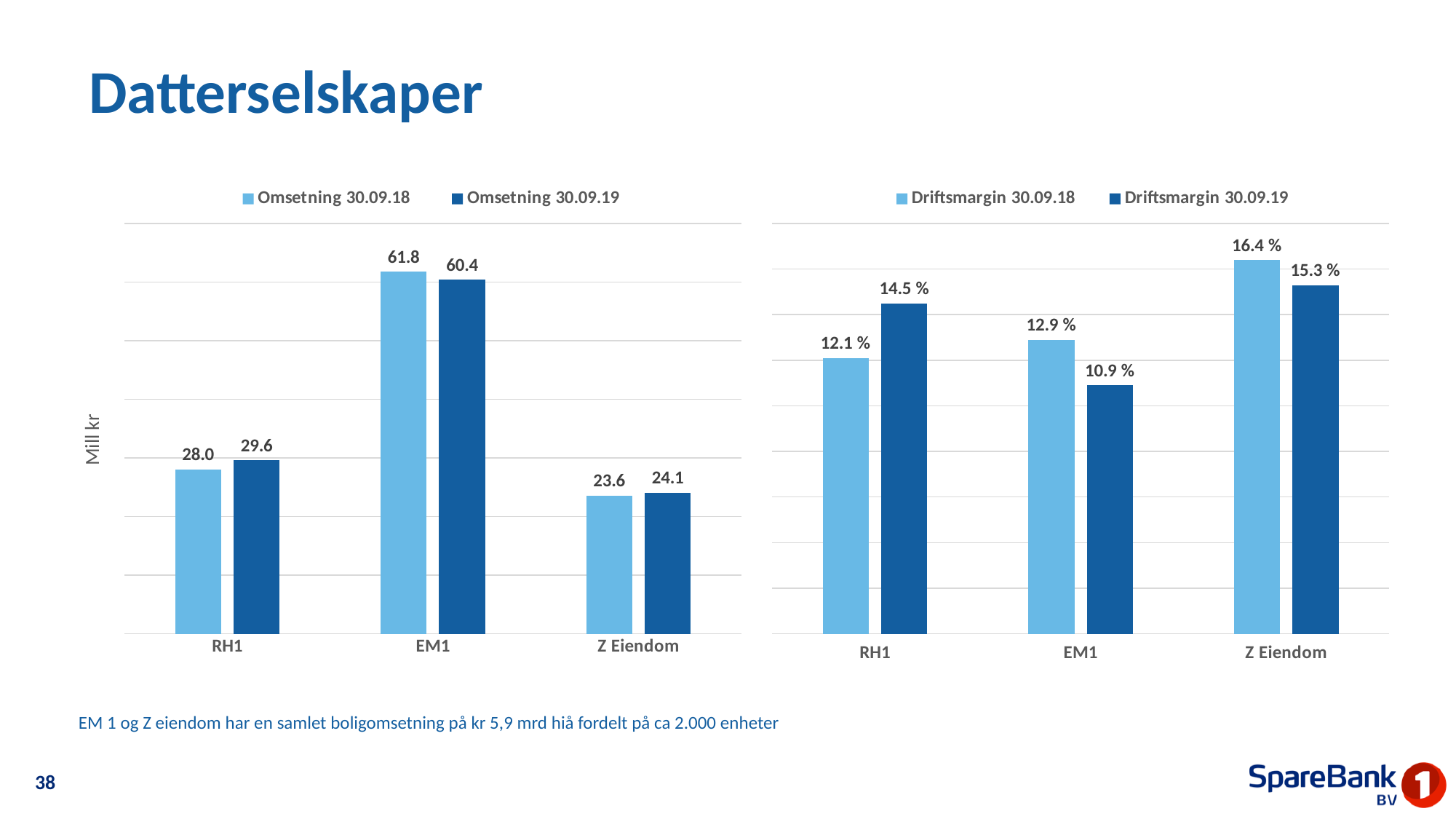
In the left chart (Omsetning), what is the Omsetning 30.09.18 value for Z Eiendom? 23.6 In the right chart (Driftsmargin), what is the Driftsmargin 30.09.19 value for RH1? 14.5 % In the right chart (Driftsmargin), what is the difference between the Driftsmargin 30.09.18 and Driftsmargin 30.09.19 values for EM1? 2.0 % In the right chart (Driftsmargin), which category has the lowest Driftsmargin 30.09.19 value? EM1 In the right chart (Driftsmargin), what is the Driftsmargin 30.09.18 value for Z Eiendom? 16.4 % In the left chart (Omsetning), what is the Omsetning 30.09.19 value for EM1? 60.4 How many categories are shown on the x axis of the left chart (Omsetning)? 3 How many series does the legend of the right chart (Driftsmargin) list? 2 In the left chart (Omsetning), what is the difference between the Omsetning 30.09.19 and Omsetning 30.09.18 values for RH1? 1.6 In the left chart (Omsetning), which category has the highest Omsetning 30.09.19 value? EM1 What kind of chart is the left chart (Omsetning)? Bar chart In the right chart (Driftsmargin), is the Driftsmargin 30.09.18 value for RH1 larger or smaller than the Driftsmargin 30.09.19 value for RH1? smaller